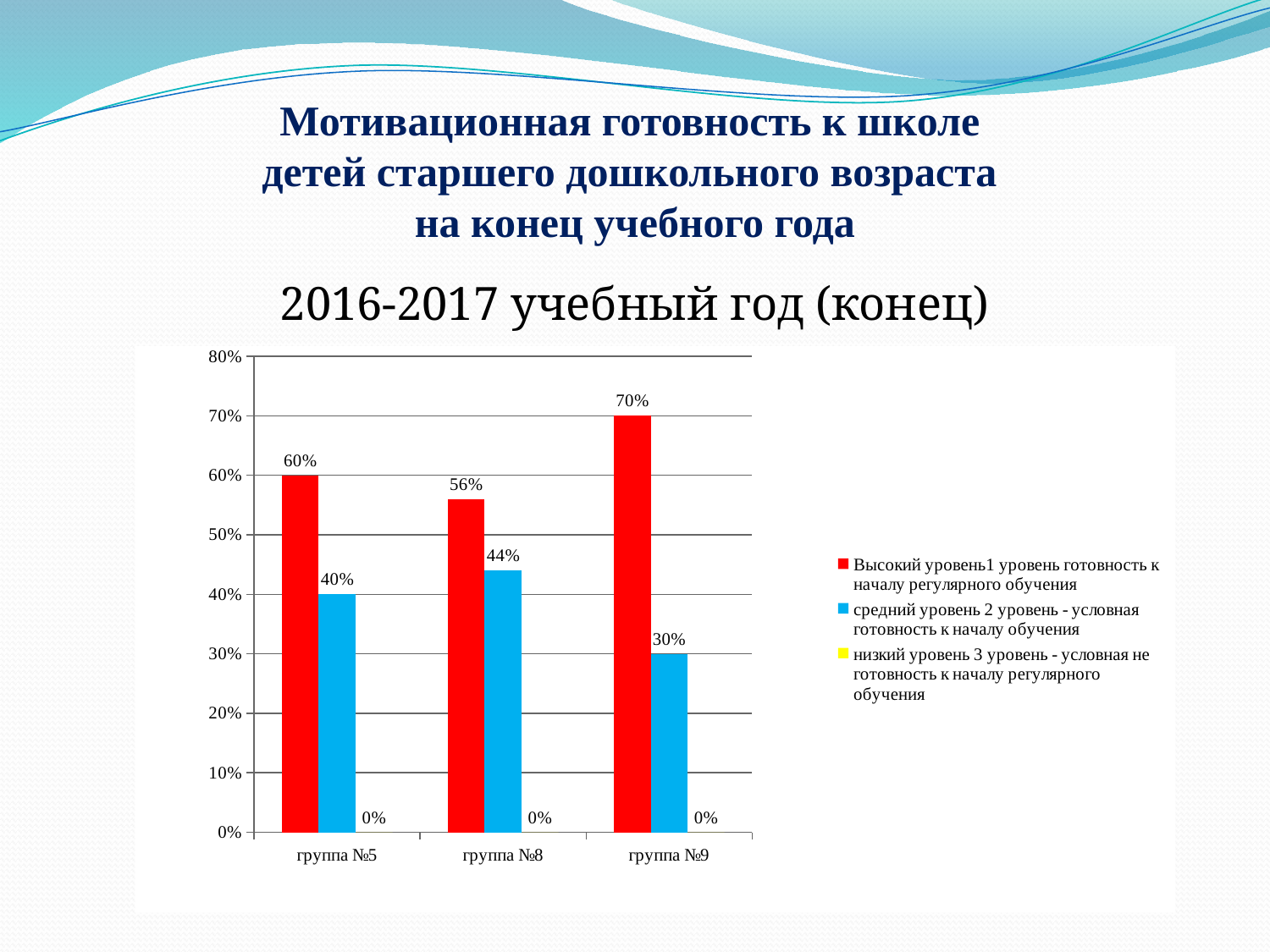
What is the difference between the high level and medium level values for группа №5? 20% What is the value of the high level (Высокий уровень) series for группа №9? 70% What kind of chart is shown on the slide? bar chart Is the medium level value for группа №9 greater or less than 40%? less How many groups are shown on the x axis? 3 How many series does the legend list? 3 What colour represents the high level (Высокий уровень) series? red Which is larger: the high level value for группа №8 or the high level value for группа №5? группа №5 What is the value of the medium level (средний уровень) series for группа №8? 44% Which group has the highest value for the high level (Высокий уровень) series? группа №9 Which group has the lowest value for the medium level (средний уровень) series? группа №9 What is the value of the low level (низкий уровень) series for группа №5? 0%